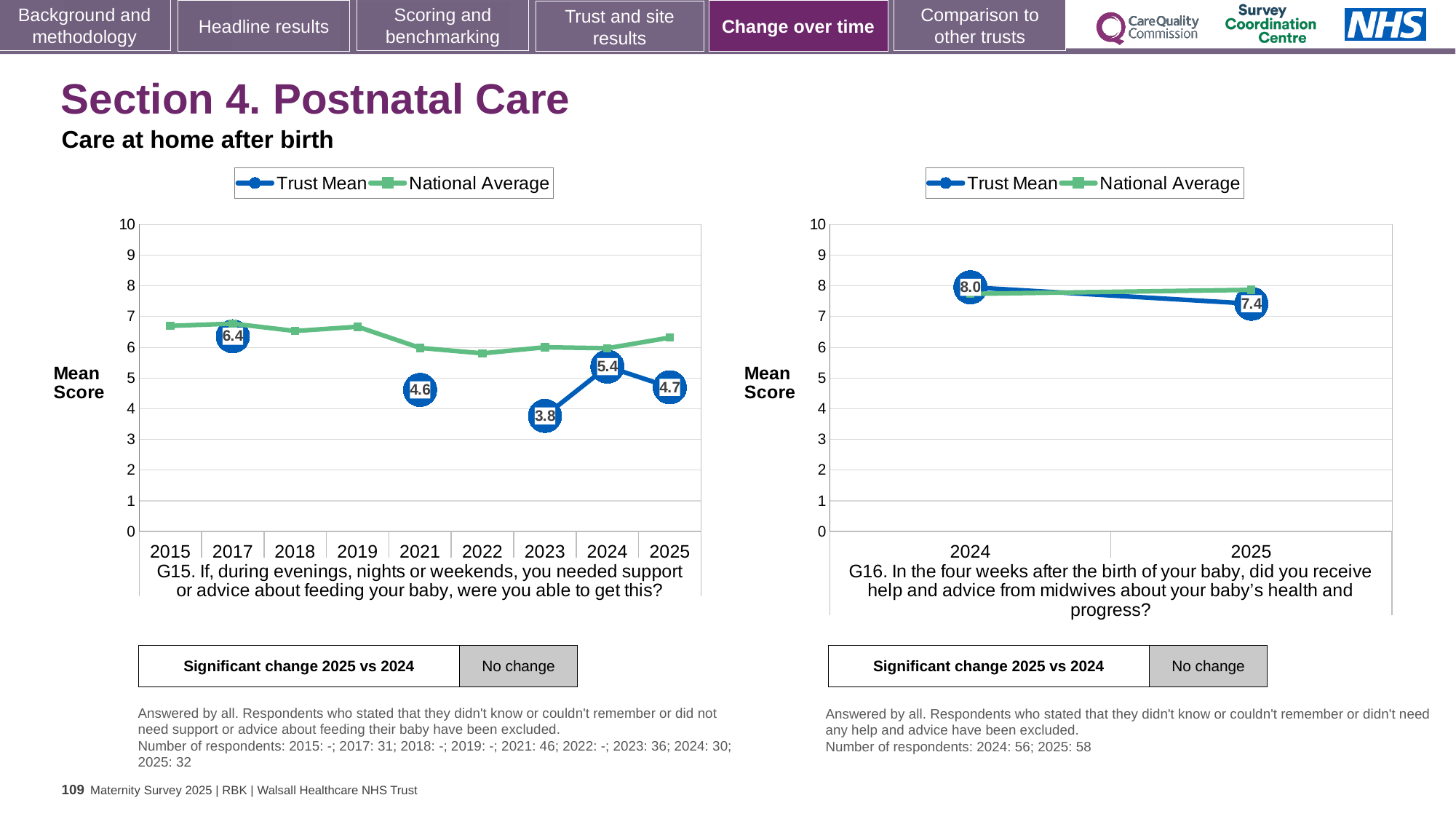
On the G16 chart (right), how many series does the legend list? 2 On the G15 chart (left), which year has the highest labelled Trust Mean score? 2017 On the G16 chart (right), what is the difference between the Trust Mean scores for 2024 and 2025? 0.6 On the G16 chart (right), what is the Trust Mean score for 2025? 7.4 On the G15 chart (left), what is the Trust Mean score for 2023? 3.8 On the G15 chart (left), what is the difference between the Trust Mean scores for 2024 and 2025? 0.7 On the G16 chart (right), does the Trust Mean rise or fall from 2024 to 2025? fall On the G15 chart (left), which year has the lowest labelled Trust Mean score? 2023 On the G15 chart (left), is the National Average value for 2015 greater or less than 6? greater On the G15 chart (left), is the Trust Mean score higher in 2021 or in 2023? 2021 On the G15 chart (left), how many years are shown on the x axis? 9 On the G15 chart (left), what is the Trust Mean score for 2017? 6.4